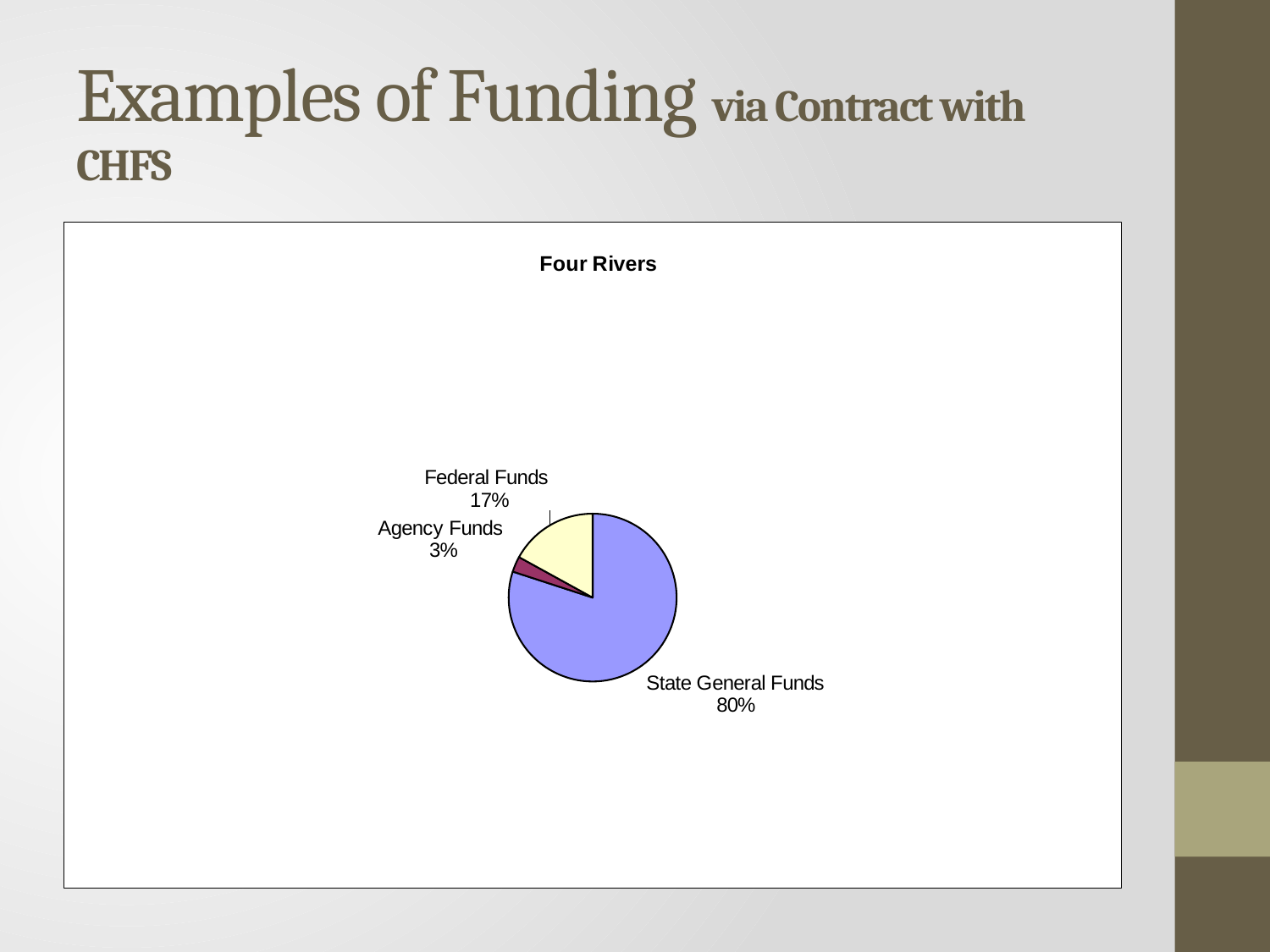
What is the difference in percentage points between State General Funds and Federal Funds? 63 What share of the pie is State General Funds? 80% Which slice of the pie is the smallest? Agency Funds What is the difference in percentage points between Federal Funds and Agency Funds? 14 What share of the pie is Agency Funds? 3% How many slices does the pie chart have? 3 What share of the pie is Federal Funds? 17% What colour is the State General Funds slice? blue What kind of chart is shown on the slide? pie chart Which slice of the pie is the largest? State General Funds Which is larger, Federal Funds or Agency Funds? Federal Funds What is the title of the chart? Four Rivers